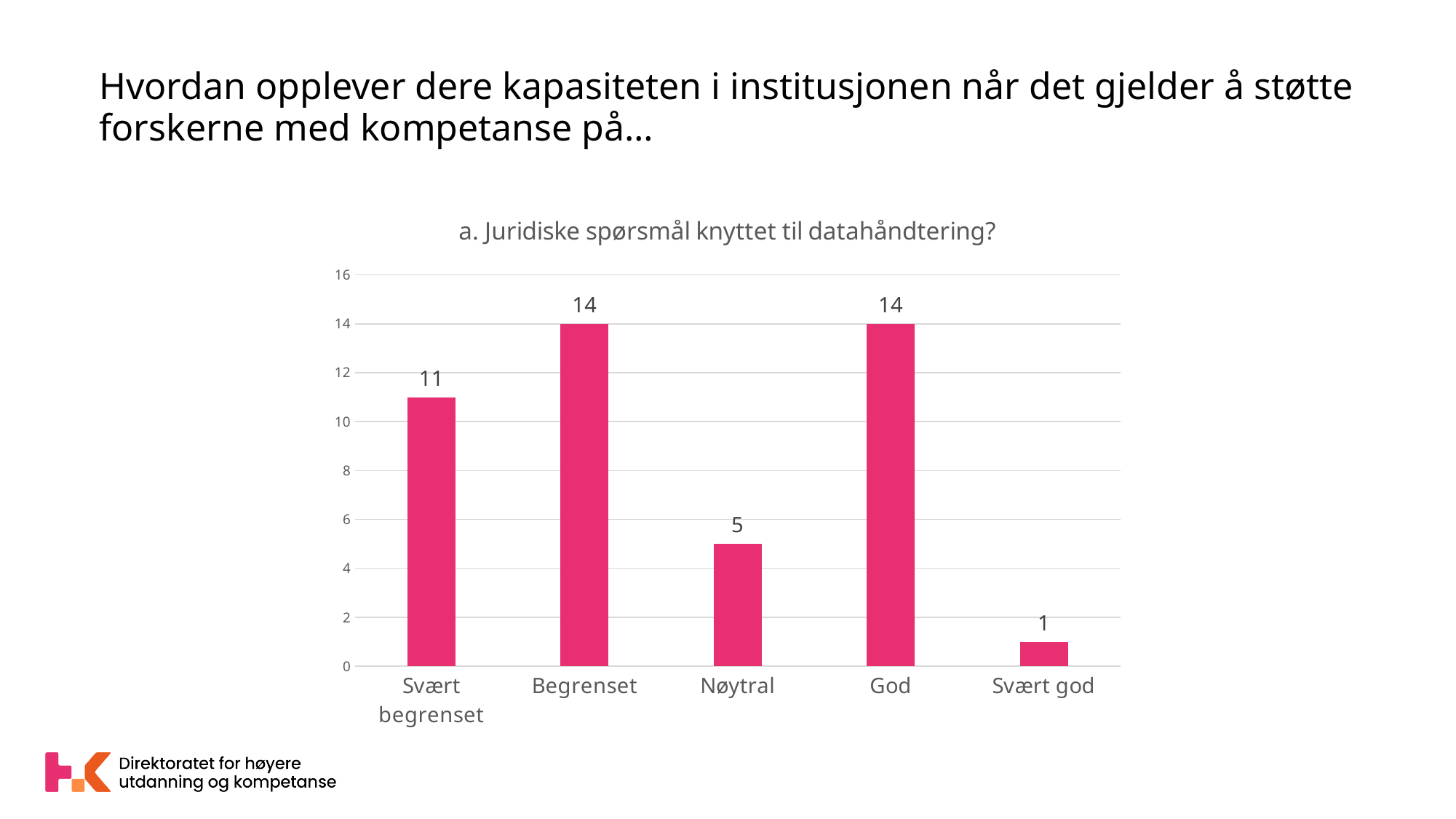
What is the value for Svært god? 1 Which is larger, the value for Svært begrenset or the value for Nøytral? Svært begrenset What is the value for Nøytral? 5 Is the value for Nøytral greater or less than 6? less Which category has the lowest value? Svært god What is the difference between the values for Begrenset and Nøytral? 9 What is the value for God? 14 What is the value for Svært begrenset? 11 How many categories are shown on the x axis? 5 What kind of chart is shown on the slide? bar chart What is the difference between the values for Svært begrenset and Svært god? 10 What is the title of the chart? a. Juridiske spørsmål knyttet til datahåndtering?